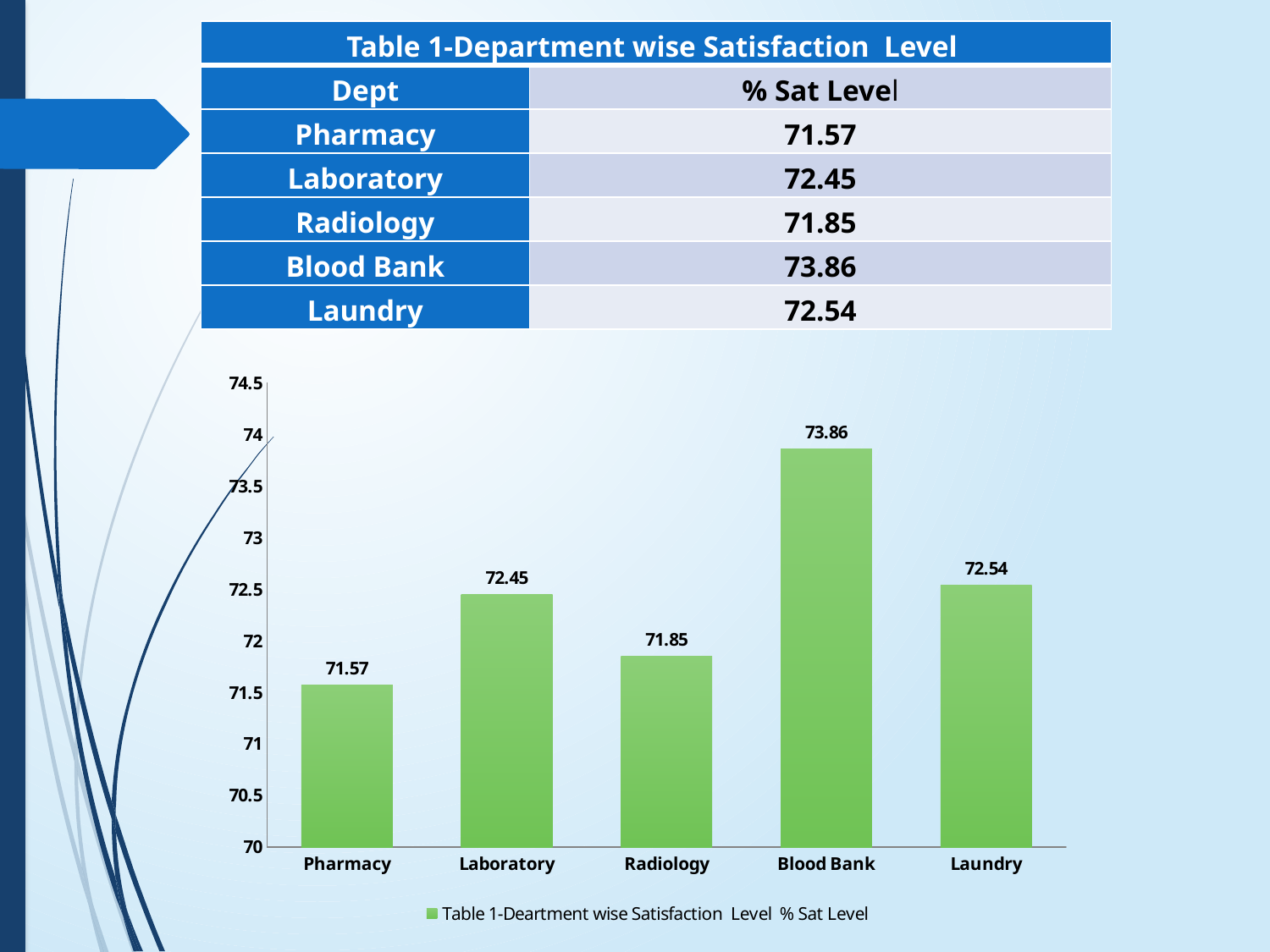
What is the difference between the values for Laundry and Laboratory? 0.09 What is the value for Pharmacy? 71.57 Which department has the highest satisfaction level? Blood Bank How many departments are shown in the chart? 5 What is the value for Blood Bank? 73.86 What is the value for Radiology? 71.85 What is the legend entry shown below the chart? Table 1-Deartment wise Satisfaction Level % Sat Level Is the value for Blood Bank greater or less than 73.5? greater Which is larger, the value for Laboratory or the value for Radiology? Laboratory Which department has the lowest satisfaction level? Pharmacy What kind of chart is shown on the slide? bar chart What is the difference between the values for Blood Bank and Pharmacy? 2.29